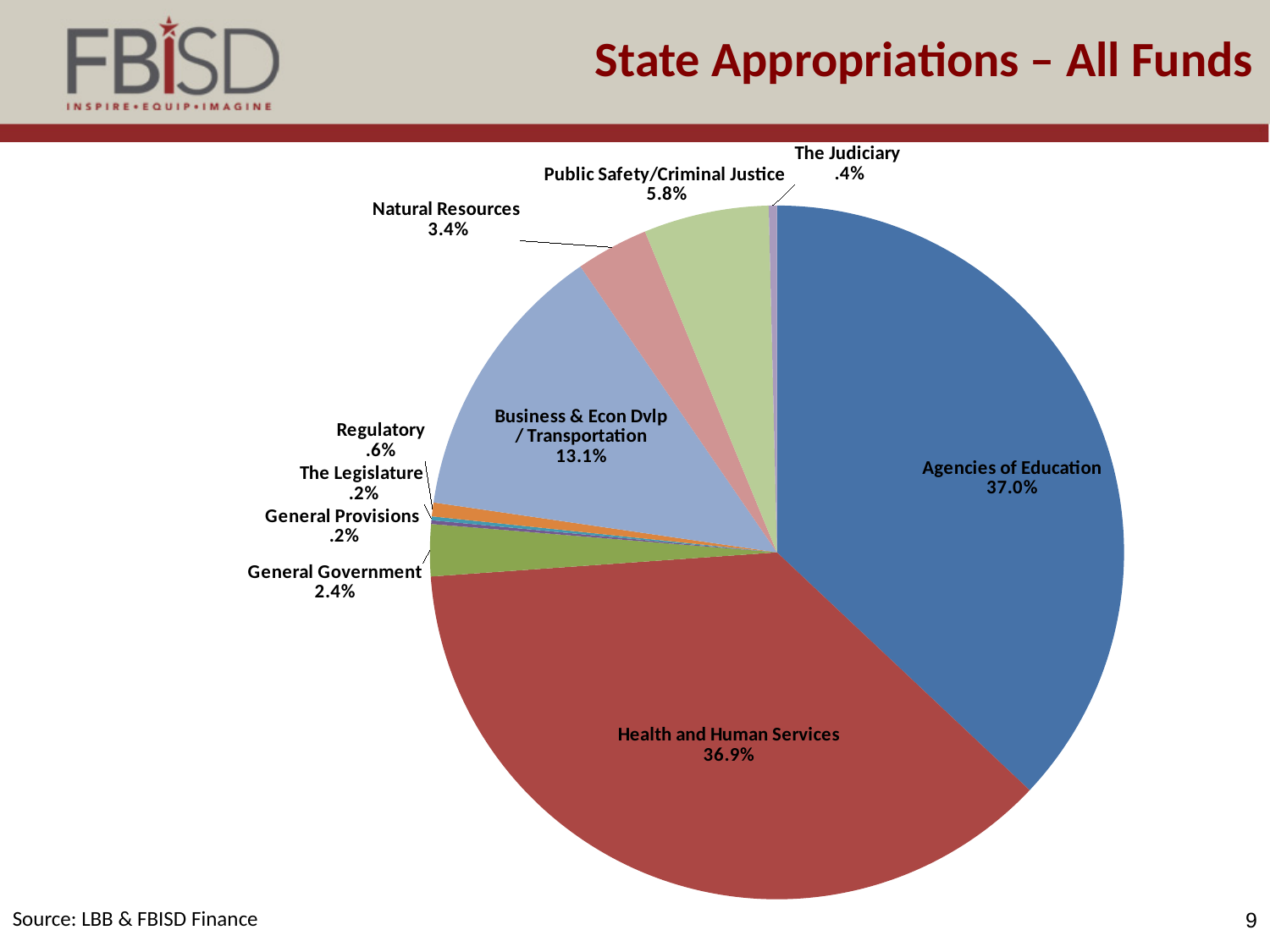
What is the title of the chart? State Appropriations – All Funds What kind of chart is shown on the slide? Pie chart Which category has the largest share of state appropriations? Agencies of Education What is the combined share of Agencies of Education and Health and Human Services? 73.9% How many categories are shown in the pie chart? 10 What percentage is shown for Business & Econ Dvlp / Transportation? 13.1% What percentage is shown for Public Safety/Criminal Justice? 5.8% What share of state appropriations goes to Health and Human Services? 36.9% Which is larger, the share for Natural Resources or the share for General Government? Natural Resources What percentage is shown for The Judiciary? .4% What is the difference in percentage points between Agencies of Education and Health and Human Services? 0.1% What share of state appropriations goes to Agencies of Education? 37.0%